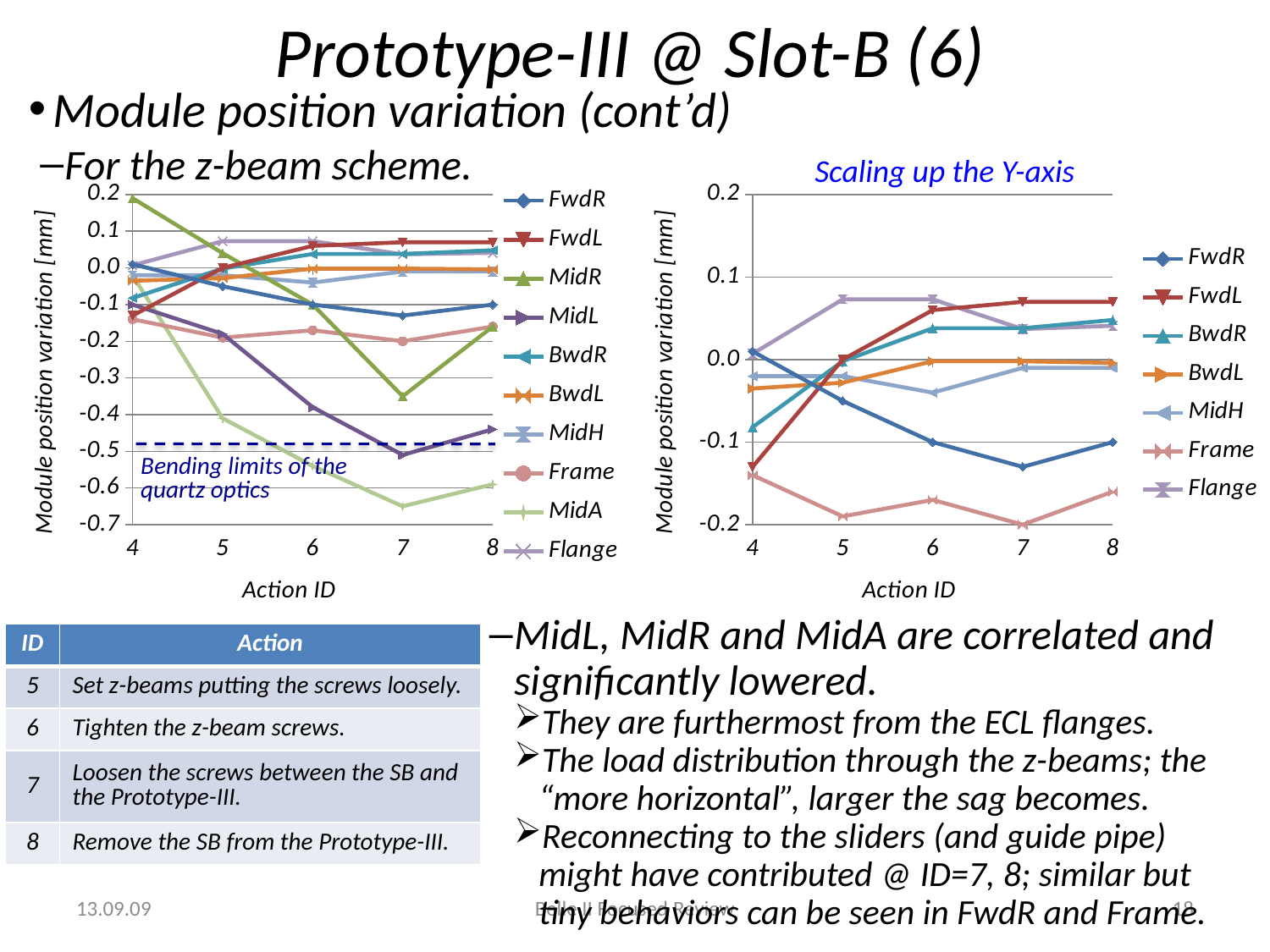
In the left chart, is the value for MidR at Action ID 4 greater or less than 0.1? greater How many series does the legend of the left chart list? 10 In the left chart, which series has the highest value at Action ID 4? MidR What type of chart is the left chart on the slide? line chart In the left chart, which series has the lowest value at Action ID 7? MidA How many Action ID values are plotted along the x axis of the left chart? 5 In the right chart (Scaling up the Y-axis), is the value for FwdR at Action ID 7 greater or less than -0.1? less How many series does the legend of the right chart (Scaling up the Y-axis) list? 7 In the right chart (Scaling up the Y-axis), which series has the lowest value at Action ID 7? Frame What is the x-axis title of the right chart? Action ID In the left chart, does the MidA series rise or fall from Action ID 4 to Action ID 7? fall In the left chart, is the value for MidA at Action ID 7 greater or less than -0.6? less